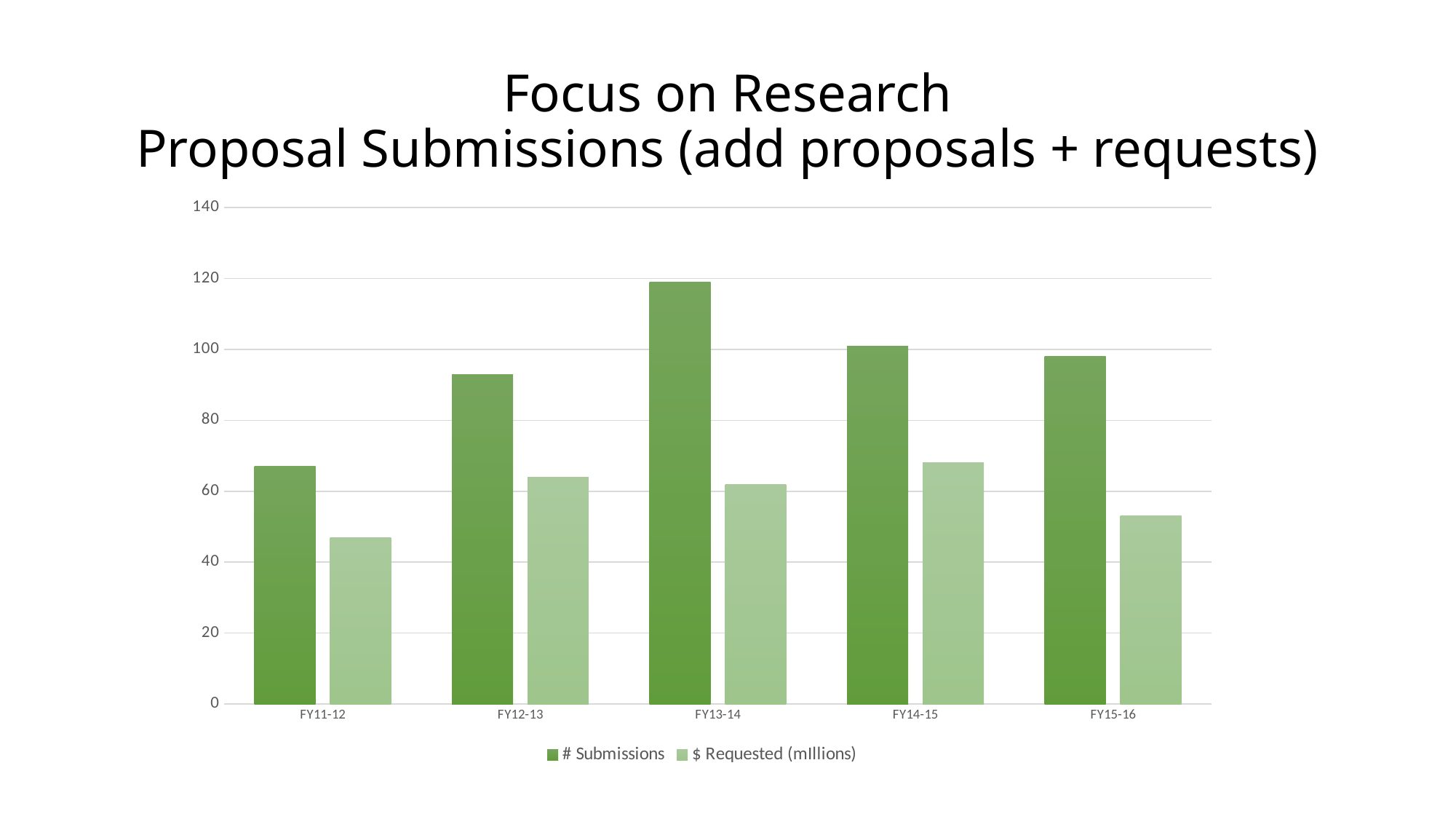
How many series does the legend list? 2 Is the number of submissions for FY12-13 greater or less than 80? greater Is the $ Requested (millions) for FY11-12 greater or less than 60? less What kind of chart is shown on the slide? bar chart Which fiscal year has the highest number of submissions? FY13-14 Do the number of submissions rise or fall from FY11-12 to FY13-14? rise Is the number of submissions for FY13-14 greater or less than 100? greater Which fiscal year has the lowest number of submissions? FY11-12 How many fiscal years are shown on the x axis? 5 Which is larger: the number of submissions in FY12-13 or in FY13-14? FY13-14 What is the second series listed in the legend? $ Requested (mIllions) Which fiscal year has the lowest $ Requested (millions)? FY11-12